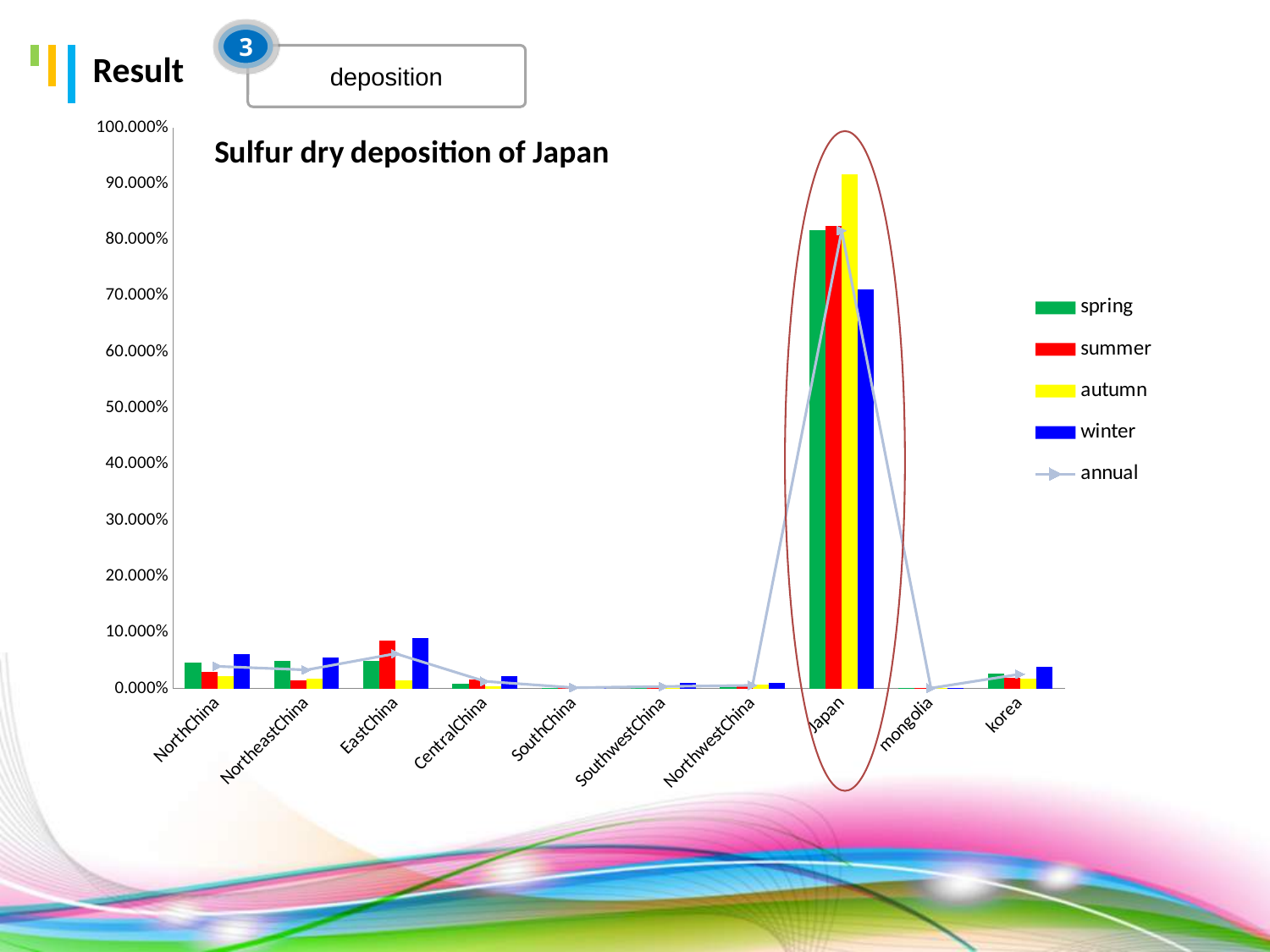
Which category has the highest values across the seasons? Japan Is the spring value for Japan greater or less than 80.000%? greater Is the winter value for Japan greater or less than 80.000%? less What kind of chart is shown on the slide? combination bar and line chart How many categories are shown on the x axis? 10 Is the autumn value for Japan greater or less than 90.000%? greater Which series is drawn as a line rather than bars? annual How many series does the legend list? 5 For Japan, which is larger: the autumn value or the winter value? autumn Which is larger: the summer value for EastChina or the summer value for NorthChina? EastChina What is the title of the chart? Sulfur dry deposition of Japan